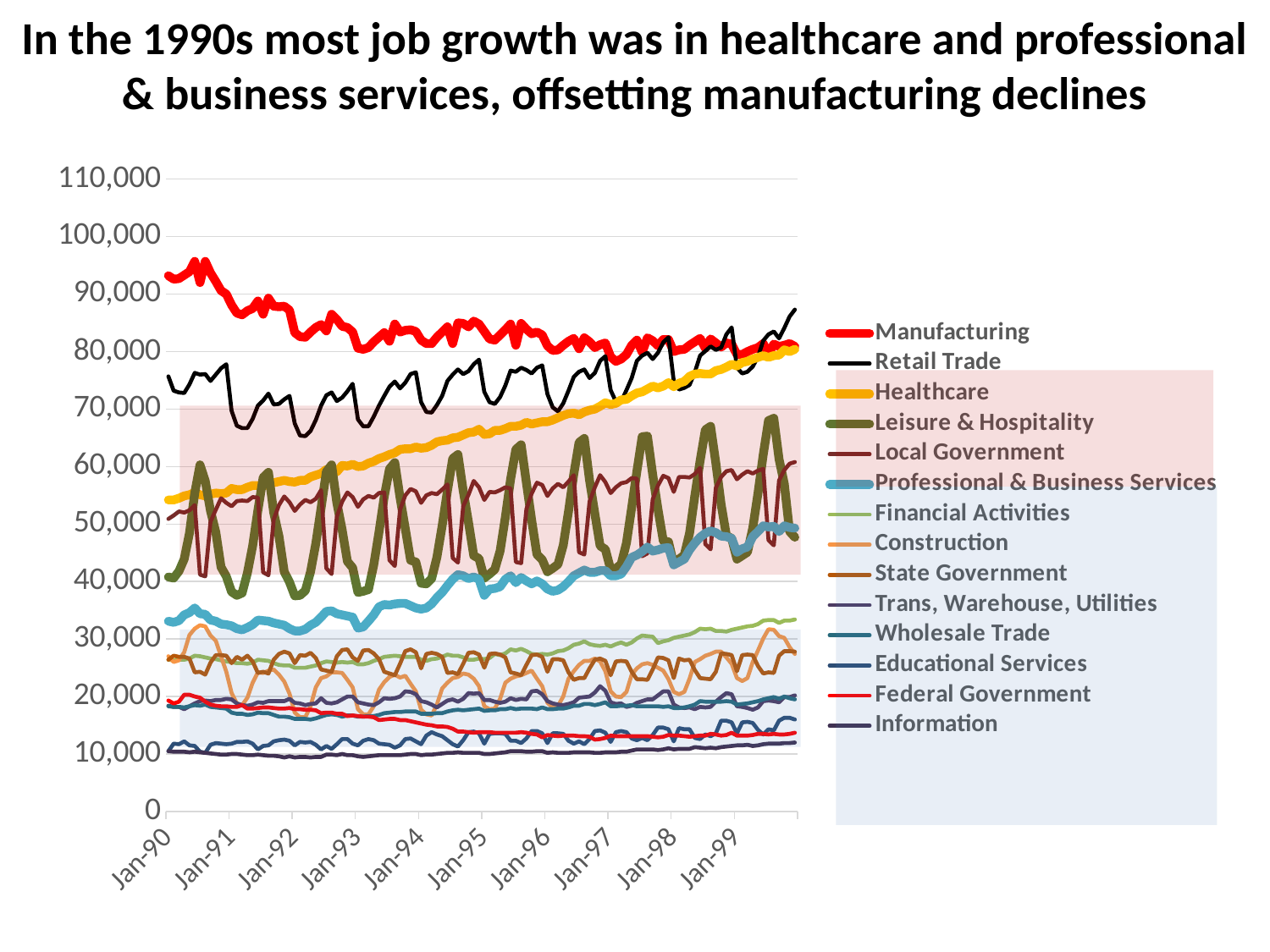
Does the Federal Government line rise or fall over the period shown? fall Does the Manufacturing line rise or fall from Jan-90 to Jan-99? fall At Jan-90, which is larger: Manufacturing or Healthcare? Manufacturing Does the Healthcare line rise or fall from Jan-90 to Jan-99? rise Which series has the highest value at Jan-90? Manufacturing What kind of chart is shown on the slide? line chart Is the Manufacturing value at Jan-90 greater or less than 90,000? greater How many series does the legend list? 14 Is the Professional & Business Services value at Jan-90 greater or less than 40,000? less Is the Healthcare value at Jan-90 greater or less than 60,000? less What colour is the Healthcare line in the legend? yellow/orange